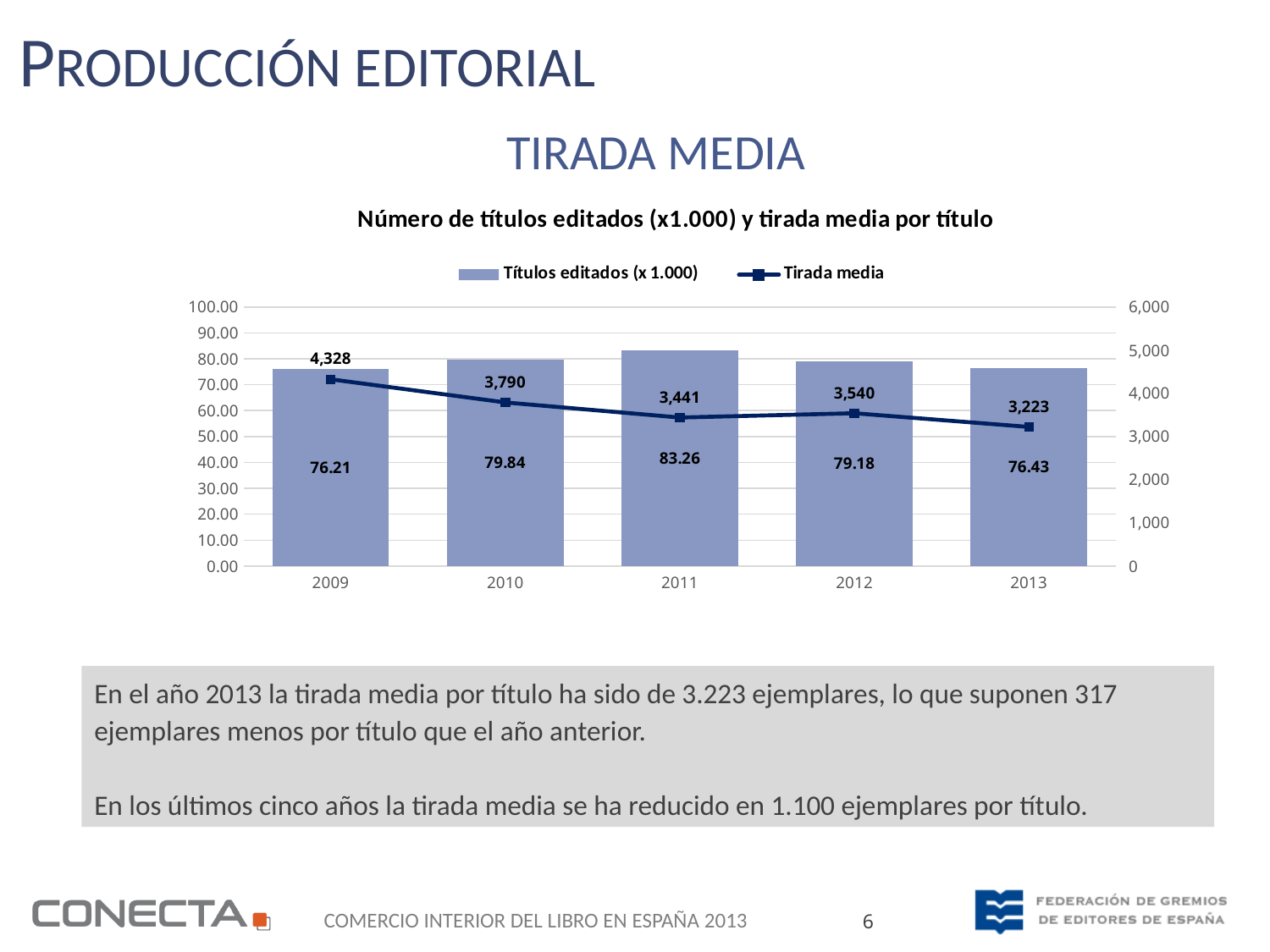
Which year has the lowest Tirada media value? 2013 What is the title of the chart? Número de títulos editados (x1.000) y tirada media por título Which year has the larger Títulos editados (x 1.000) value, 2010 or 2012? 2010 How many series does the legend list? 2 How many years are shown on the x axis? 5 Which year has the highest value for Títulos editados (x 1.000)? 2011 What is the difference in Tirada media between 2012 and 2013? 317 What is the value of Títulos editados (x 1.000) for 2011? 83.26 What is the Tirada media value for 2013? 3,223 Does the Tirada media line generally rise or fall from 2009 to 2013? Fall What kind of chart is shown on the slide? Combined bar and line chart What is the Tirada media value for 2009? 4,328